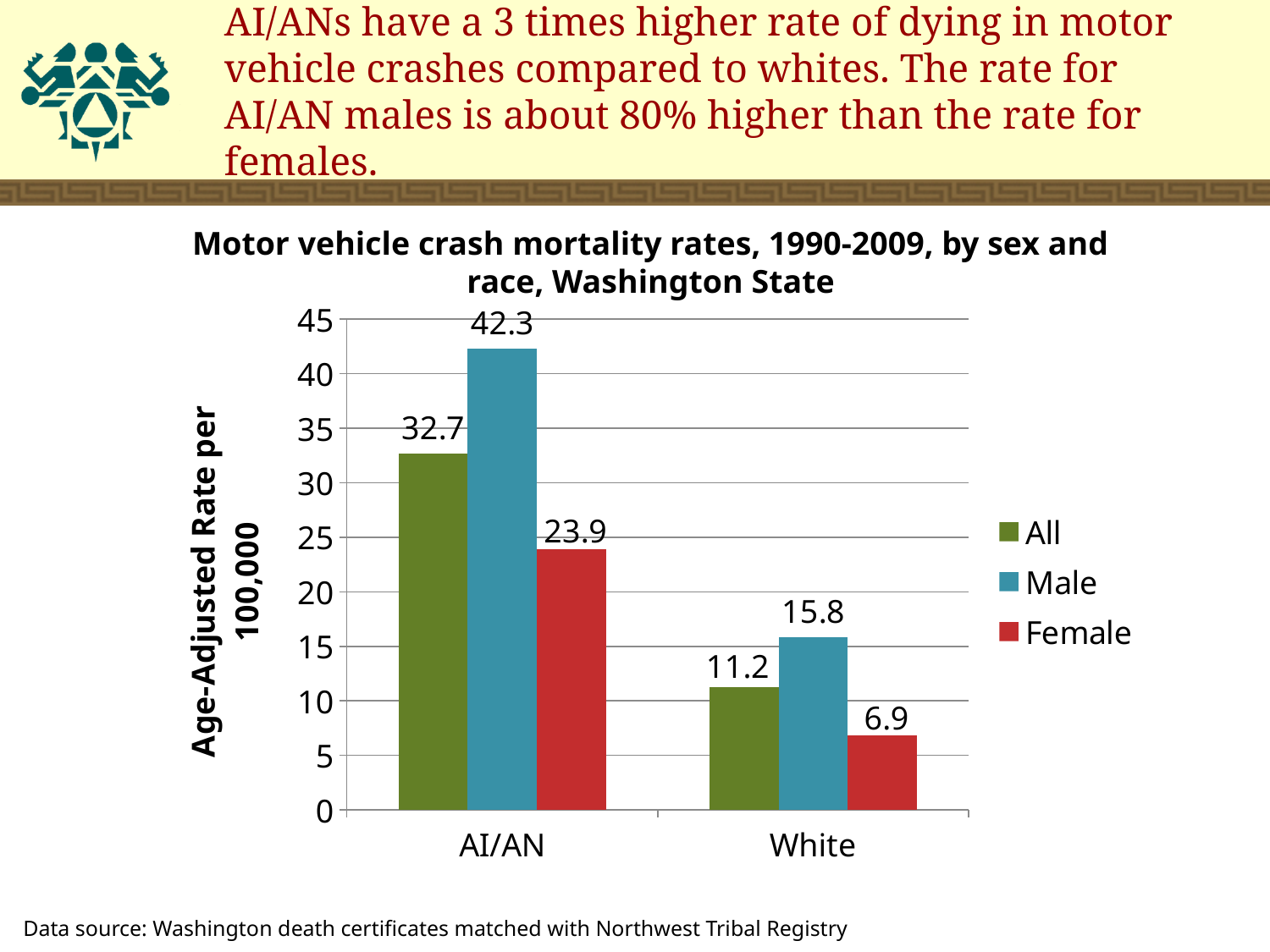
How many series does the legend list? 3 Which is larger, the Female rate for AI/AN or the Male rate for White? Female rate for AI/AN What is the label of the vertical axis? Age-Adjusted Rate per 100,000 What is the value of the All series for the White category? 11.2 What is the difference between the Male rate for AI/AN and the Male rate for White? 26.5 Which bar on the chart has the lowest value? White Female What is the difference between the AI/AN Male rate and the AI/AN Female rate? 18.4 How many race categories are shown on the x axis? 2 Which bar on the chart has the highest value? AI/AN Male What kind of chart is shown on the slide? Bar chart What is the motor vehicle crash mortality rate for AI/AN males? 42.3 What is the motor vehicle crash mortality rate for White females? 6.9